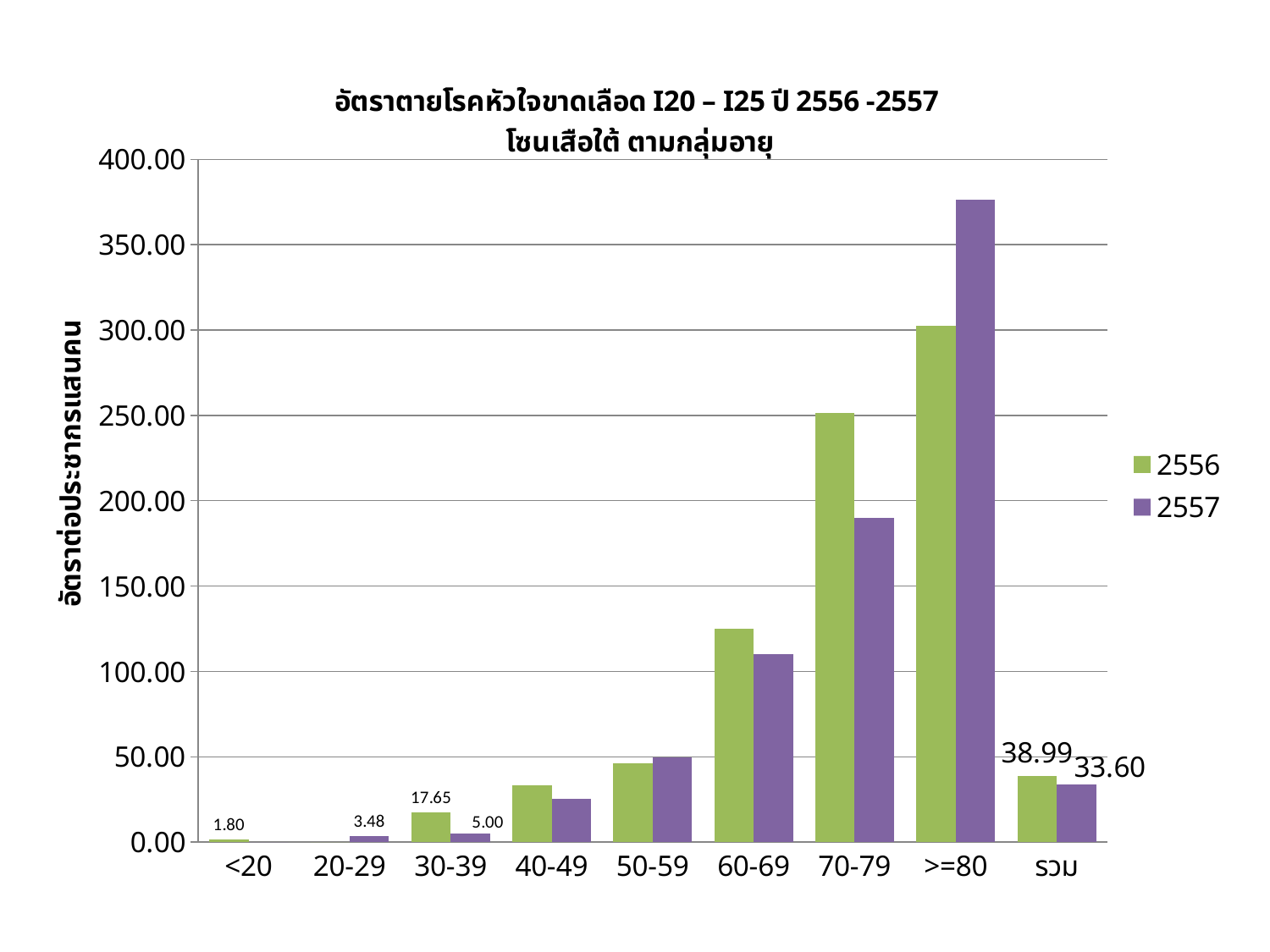
Is the value for the 2556 series in the 60-69 age group greater or less than 100.00? greater What is the value for the 2556 series in the <20 age group? 1.80 How many categories are shown on the x axis? 9 What is the value for the 2557 series in the รวม category? 33.60 How many series does the legend list? 2 What is the difference between the 2556 and 2557 values in the 30-39 age group? 12.65 What is the value for the 2556 series in the 30-39 age group? 17.65 What is the difference between the 2556 and 2557 values in the รวม category? 5.39 Which age group has the highest value for the 2557 series? >=80 Is the value for the 2557 series in the >=80 age group greater or less than 350.00? greater What is the value for the 2557 series in the 20-29 age group? 3.48 In the 70-79 age group, which series has the larger value, 2556 or 2557? 2556